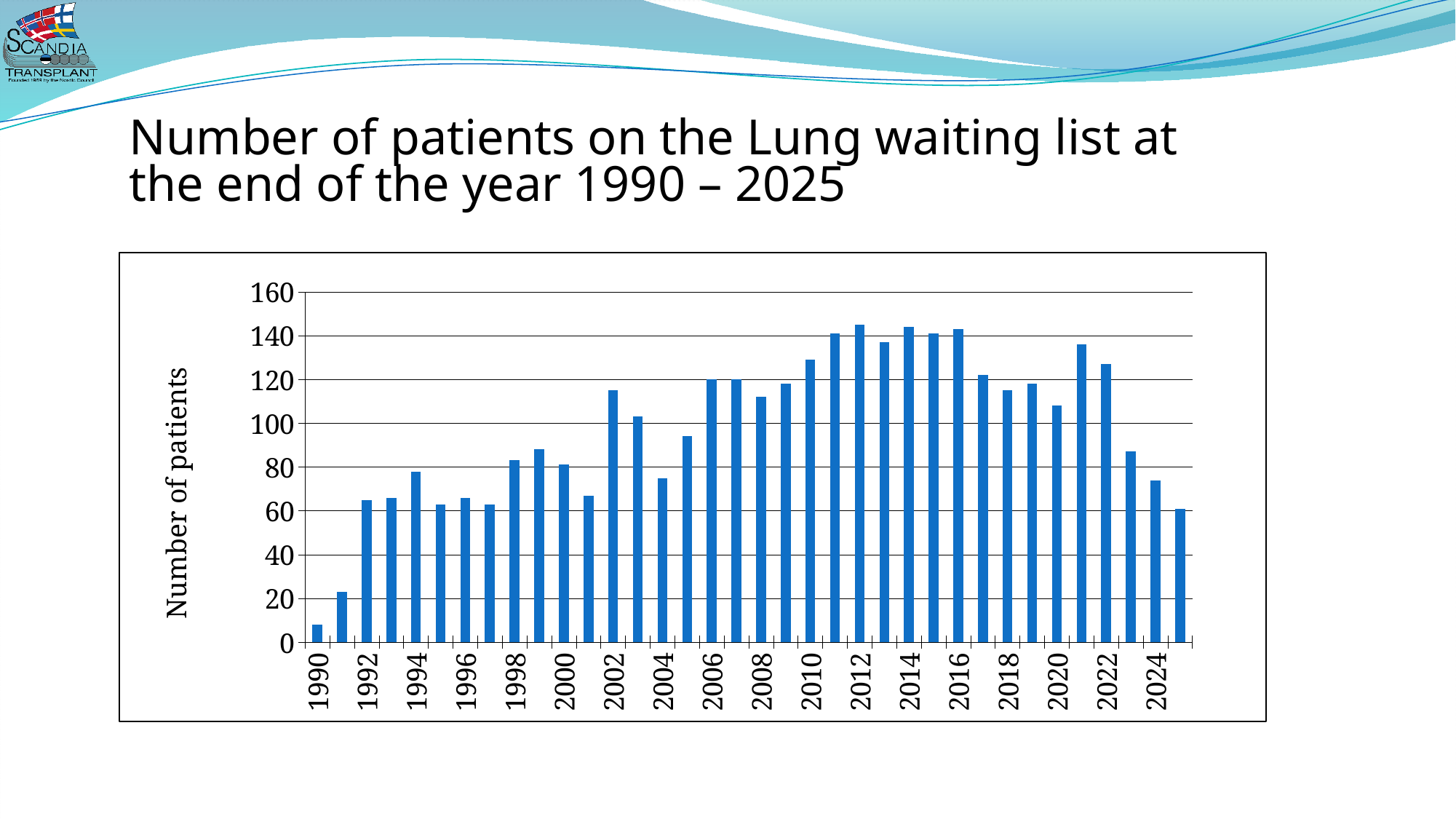
How many years (bars) are plotted in the chart? 36 Is the value for 2004 greater or less than 80? less Is the value for 2002 greater or less than 100? greater Is the value for 1990 greater or less than 20? less Which year has the larger value, 2002 or 2004? 2002 Which year has the lowest number of patients on the lung waiting list? 1990 Do the values rise or fall from 2021 to 2025? fall What is the label on the vertical axis of the chart? Number of patients Which year has the larger value, 2021 or 2022? 2021 What kind of chart is shown on the slide? bar chart